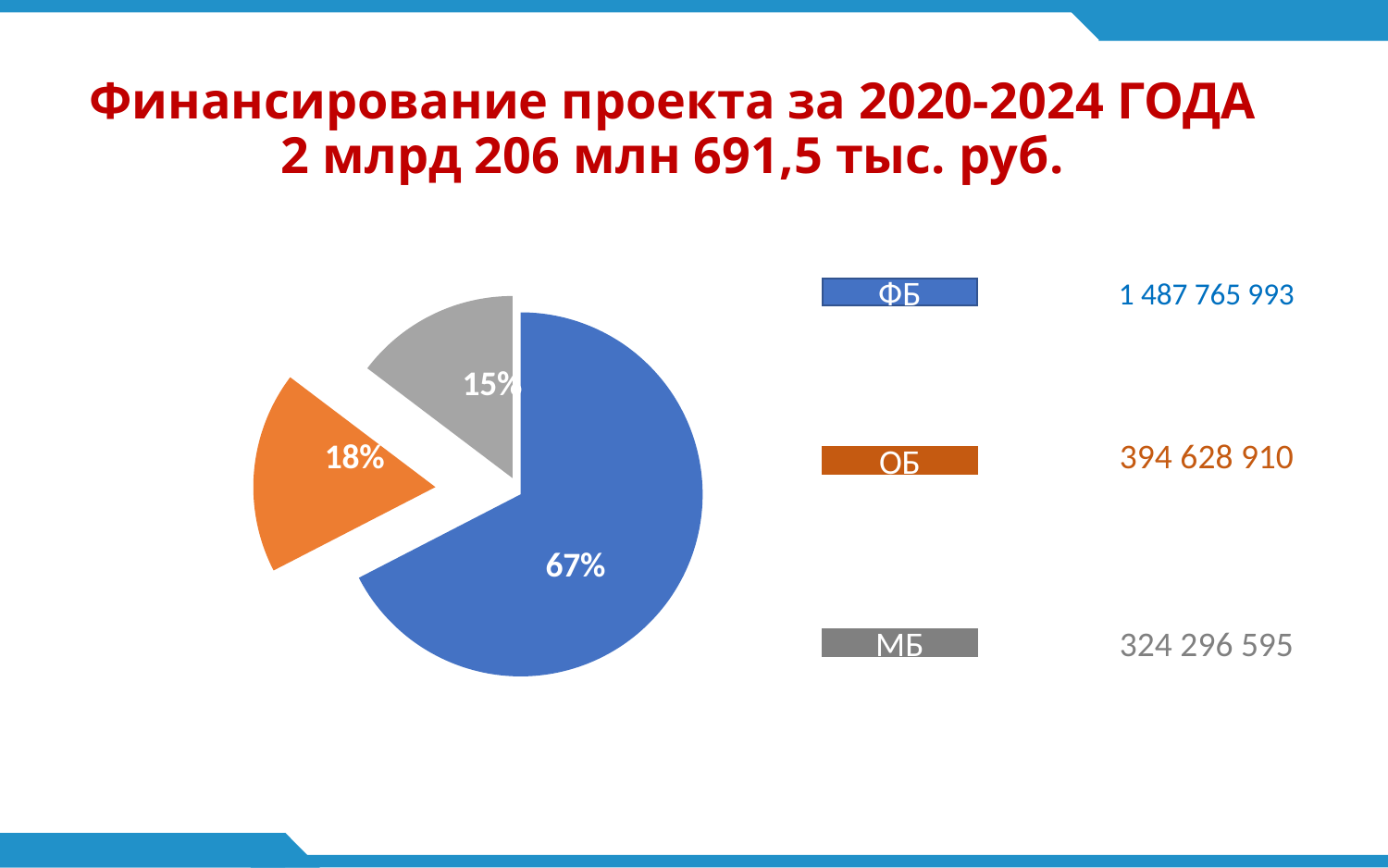
What value is shown next to МБ in the legend? 324 296 595 Which category has the largest slice of the pie? ФБ What value is shown next to ОБ in the legend? 394 628 910 What share of the pie does ФБ represent? 67% What value is shown next to ФБ in the legend? 1 487 765 993 By how many percentage points does the ФБ share exceed the ОБ share? 49 percentage points What type of chart is shown on the slide? Pie chart Which is larger, the share for ОБ or the share for МБ? ОБ What share of the pie does МБ represent? 15% What share of the pie does ОБ represent? 18% Which category has the smallest slice of the pie? МБ How many slices does the pie chart have? 3